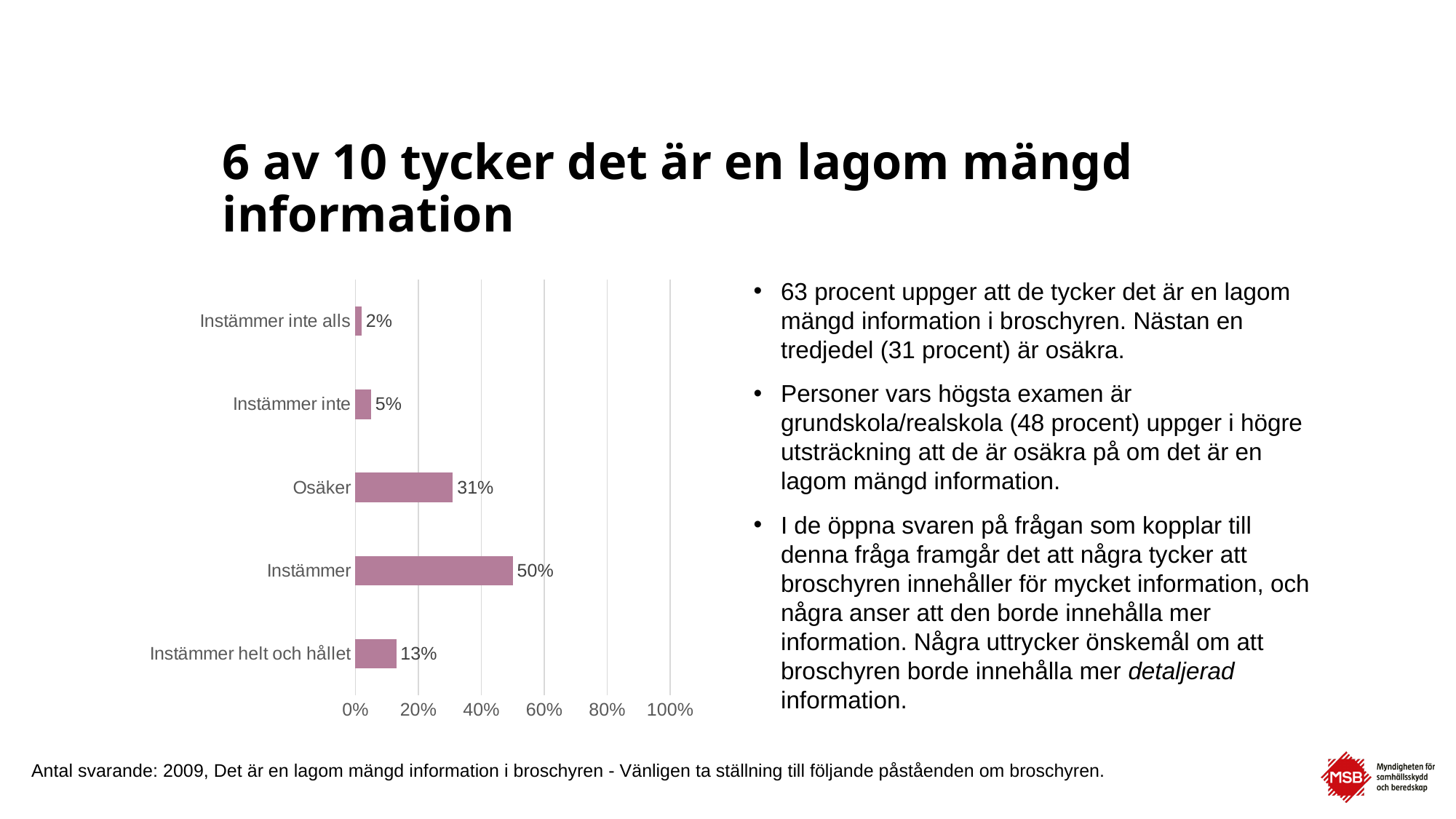
Which is larger, the value for "Instämmer helt och hållet" or the value for "Instämmer inte"? Instämmer helt och hållet What is the combined value of "Instämmer" and "Instämmer helt och hållet"? 63% Which category has the lowest value? Instämmer inte alls Which category has the highest value? Instämmer What is the value for "Instämmer helt och hållet"? 13% How many categories are shown in the chart? 5 Is the value for "Osäker" greater or less than 40%? less What kind of chart is shown on the slide? bar chart What is the value for "Osäker"? 31% What is the value for "Instämmer"? 50% What is the difference between the values for "Instämmer" and "Osäker"? 19% What is the value for "Instämmer inte alls"? 2%